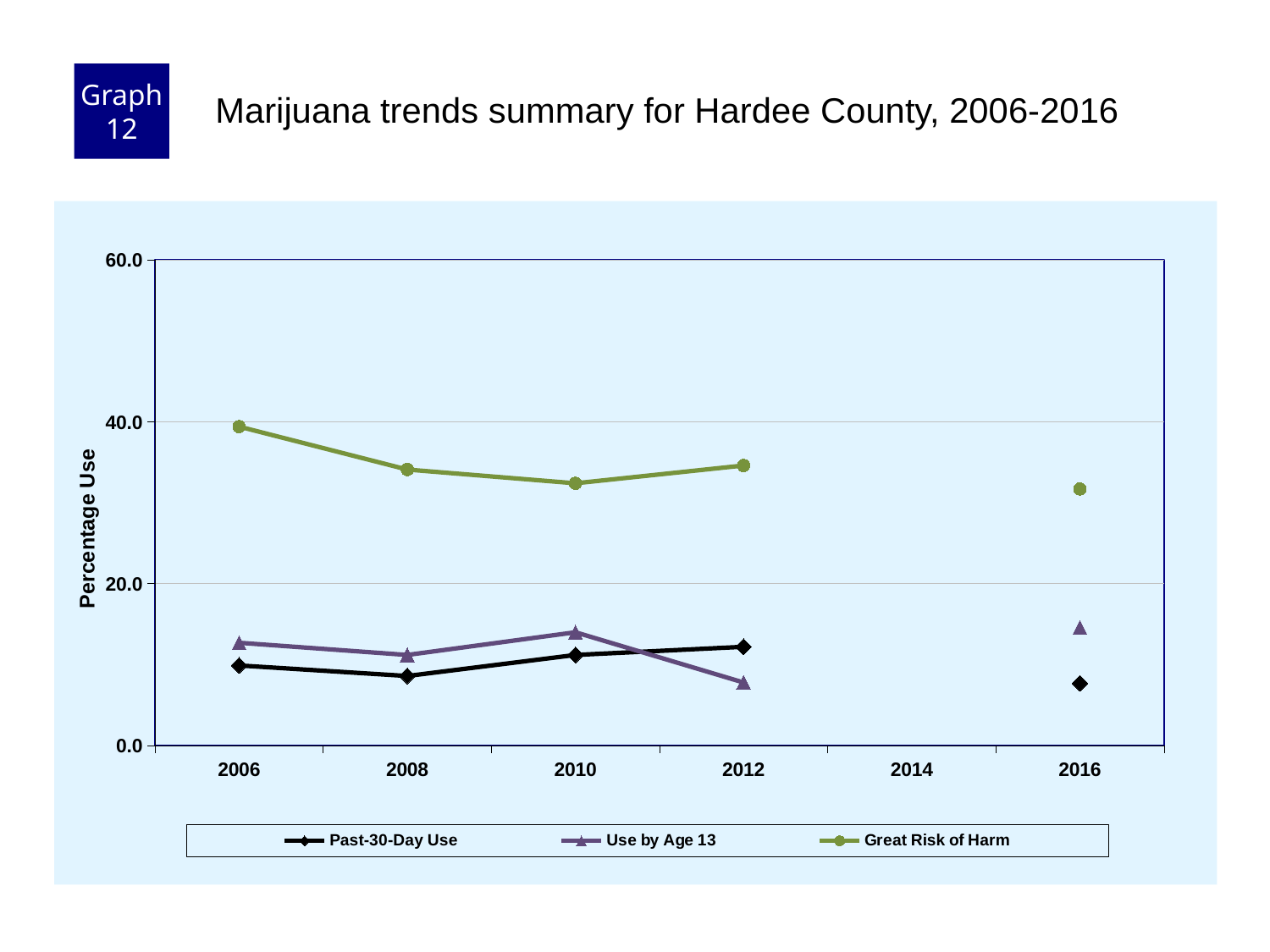
Which series has the highest values across all years shown? Great Risk of Harm Is the value for Great Risk of Harm in 2010 greater or less than 40.0? less How many years are labelled on the x axis? 6 What is the label on the y axis? Percentage Use In 2012, which is larger: Past-30-Day Use or Use by Age 13? Past-30-Day Use Does the Great Risk of Harm series rise or fall from 2006 to 2010? fall How many series does the legend list? 3 Which year on the x axis has no data points plotted? 2014 What kind of chart is shown on the slide? line chart Is the value for Great Risk of Harm in 2006 greater or less than 20.0? greater Is the value for Past-30-Day Use in 2016 greater or less than 20.0? less In which year is the Great Risk of Harm value highest? 2006